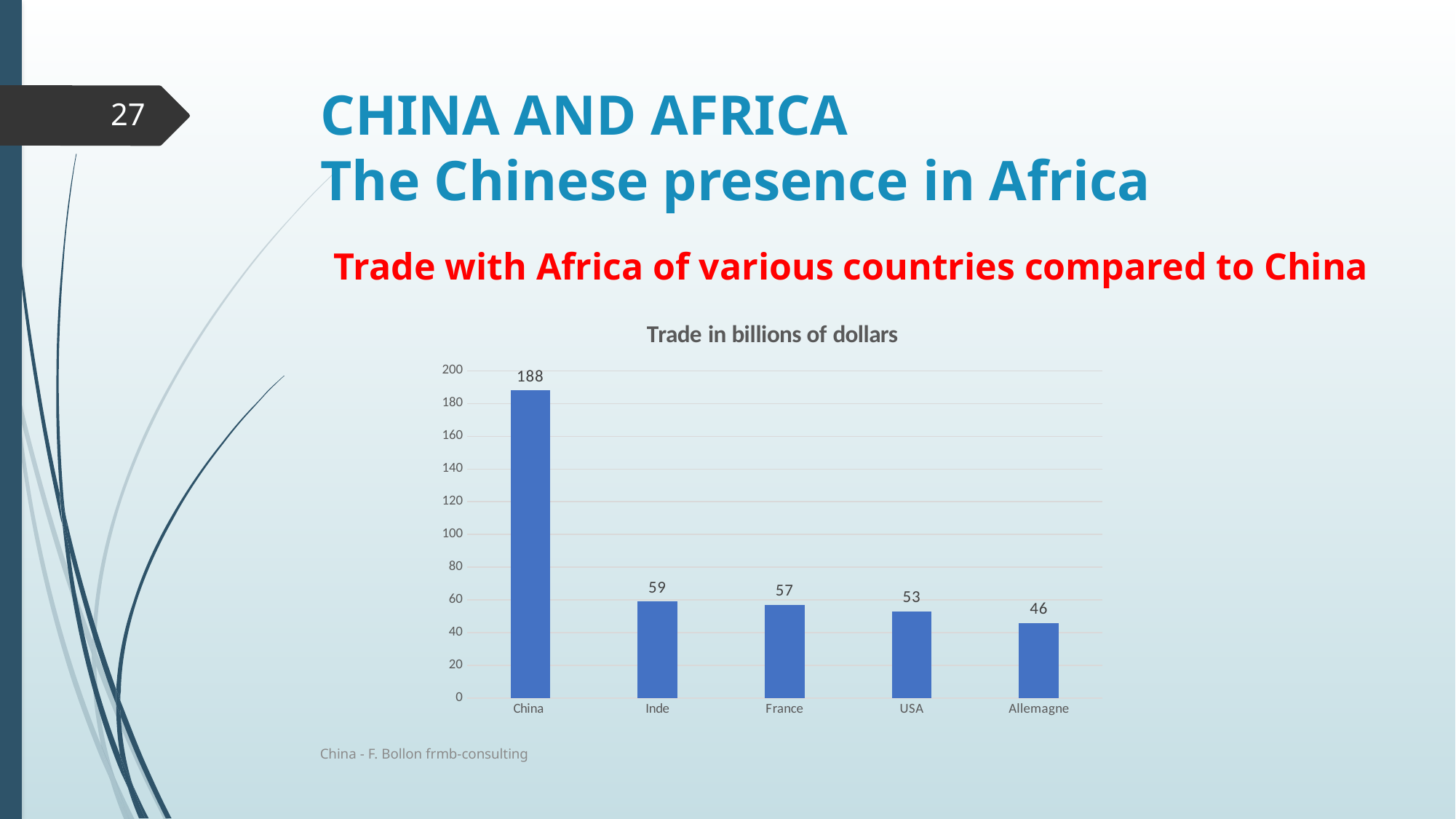
How many countries are shown in the chart? 5 What kind of chart is shown on the slide? bar chart What is the value for China in the chart? 188 Which country has the highest trade value in the chart? China What is the difference between the values for China and USA? 135 Which has a larger value, Inde or USA? Inde What is the value for Allemagne in the chart? 46 Which country has the lowest trade value in the chart? Allemagne What is the title of the chart? Trade in billions of dollars What is the value for Inde in the chart? 59 Is the value for France greater or less than 100? less What is the difference between the values for France and Allemagne? 11